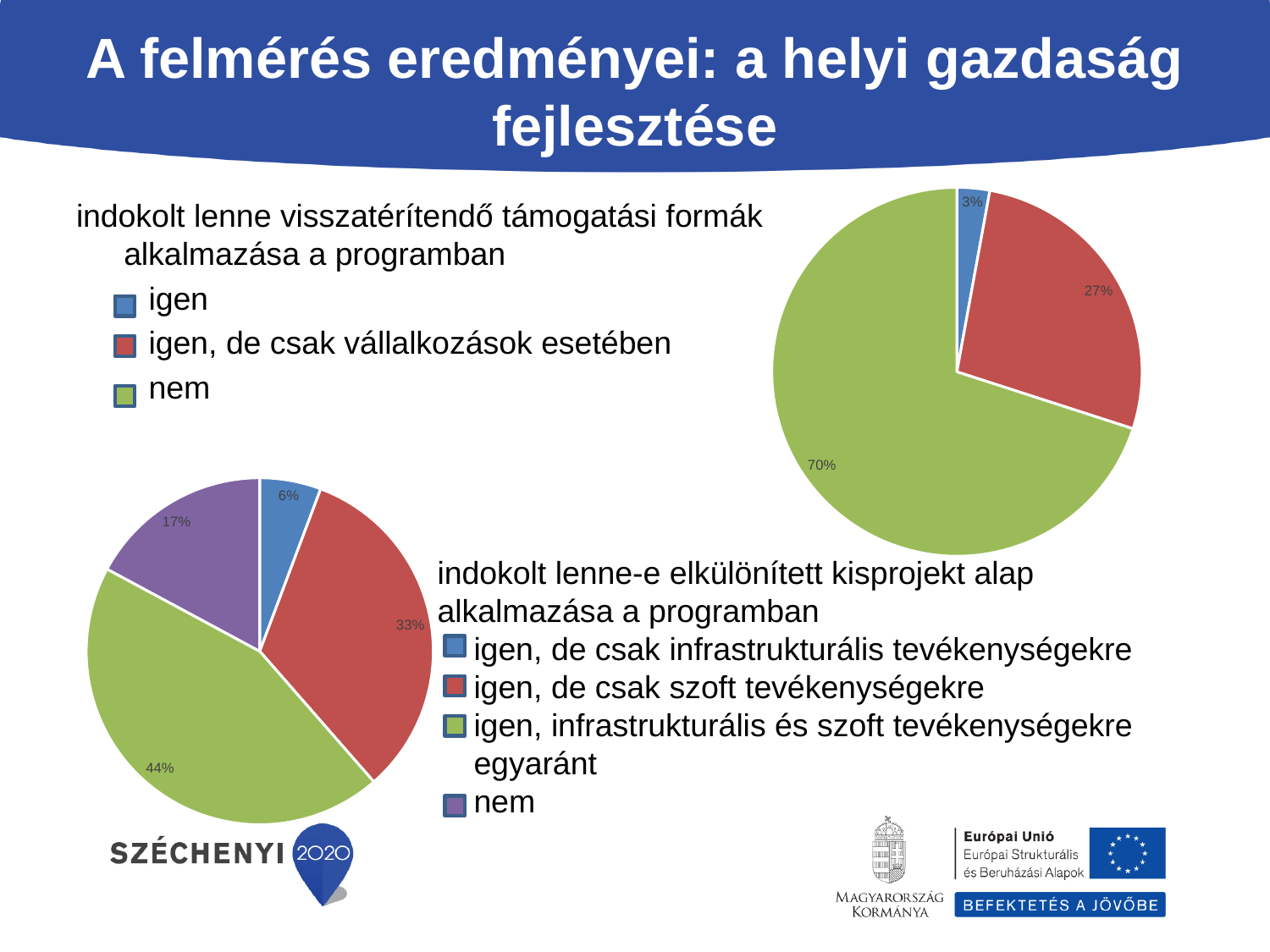
In the pie chart at the top right (visszatérítendő támogatási formák), what share is labelled for 'igen, de csak vállalkozások esetében'? 27% In the pie chart at the bottom left (elkülönített kisprojekt alap), what share is labelled for 'igen, de csak szoft tevékenységekre'? 33% In the pie chart at the bottom left (elkülönített kisprojekt alap), which answer has the smallest share? igen, de csak infrastrukturális tevékenységekre In the pie chart at the top right (visszatérítendő támogatási formák), what share is labelled for 'nem'? 70% In the pie chart at the bottom left (elkülönített kisprojekt alap), what share is labelled for 'igen, infrastrukturális és szoft tevékenységekre egyaránt'? 44% In the pie chart at the top right (visszatérítendő támogatási formák), what share is labelled for 'igen'? 3% In the pie chart at the top right (visszatérítendő támogatási formák), what is the difference in percentage points between 'nem' and 'igen, de csak vállalkozások esetében'? 43 percentage points How many categories does the legend of the bottom-left pie chart (elkülönített kisprojekt alap) list? 4 In the pie chart at the top right (visszatérítendő támogatási formák), which answer has the largest share? nem In the pie chart at the top right (visszatérítendő támogatási formák), which answer has the smallest share? igen In the pie chart at the bottom left (elkülönített kisprojekt alap), what share is labelled for 'nem'? 17% What type of chart is used for the top-right chart (visszatérítendő támogatási formák)? Pie chart